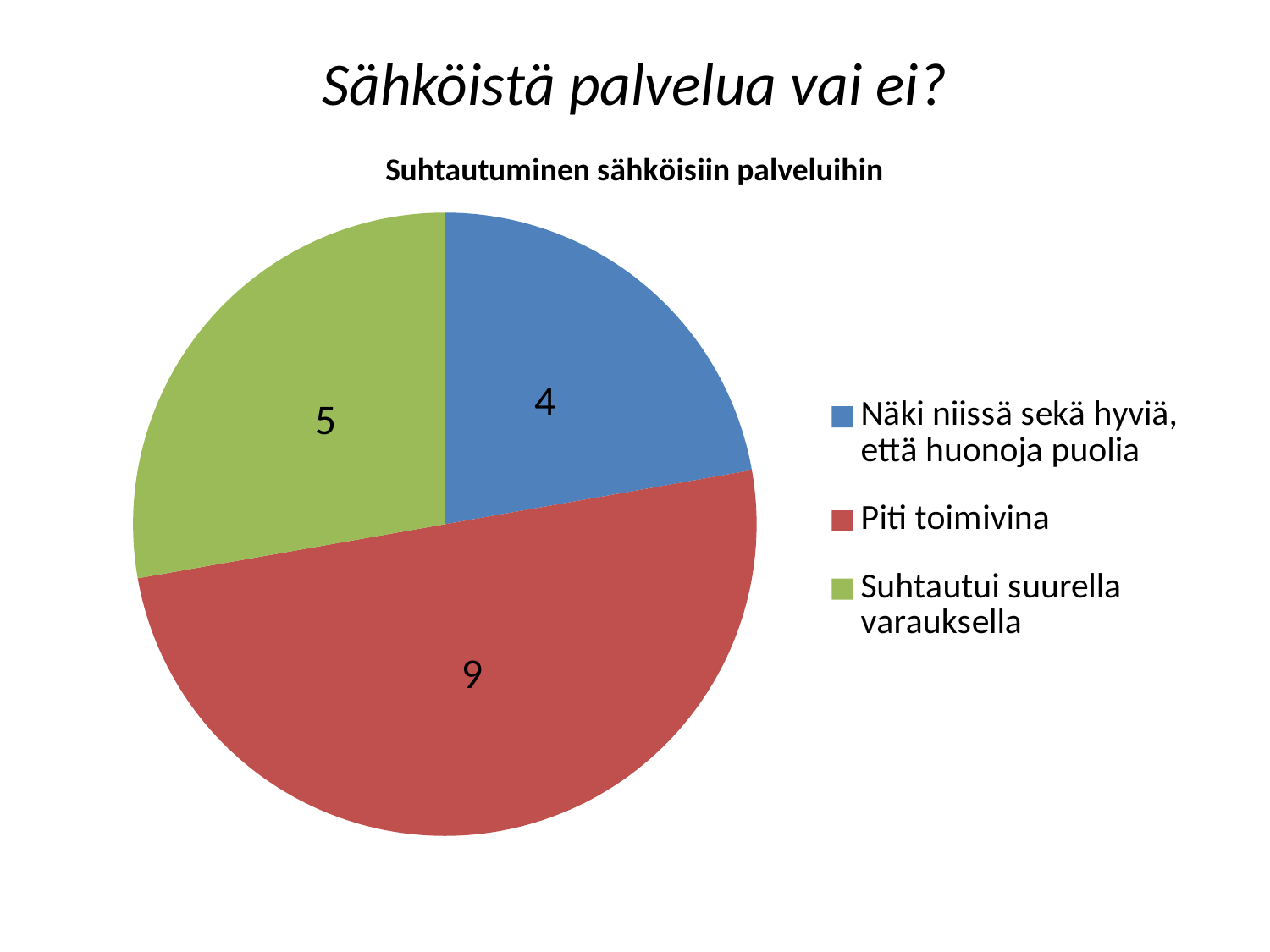
What is the title of the chart? Suhtautuminen sähköisiin palveluihin Which category has the smallest slice? Näki niissä sekä hyviä, että huonoja puolia Which is larger: the value for "Suhtautui suurella varauksella" or the value for "Näki niissä sekä hyviä, että huonoja puolia"? Suhtautui suurella varauksella What is the total of all slices in the pie chart? 18 Which category has the largest slice? Piti toimivina What type of chart is shown on the slide? pie chart How many categories does the pie chart have? 3 What is the difference between the values for "Piti toimivina" and "Suhtautui suurella varauksella"? 4 What is the value for "Piti toimivina"? 9 What is the value for "Näki niissä sekä hyviä, että huonoja puolia"? 4 What is the value for "Suhtautui suurella varauksella"? 5 What colour is the slice for "Piti toimivina"? red